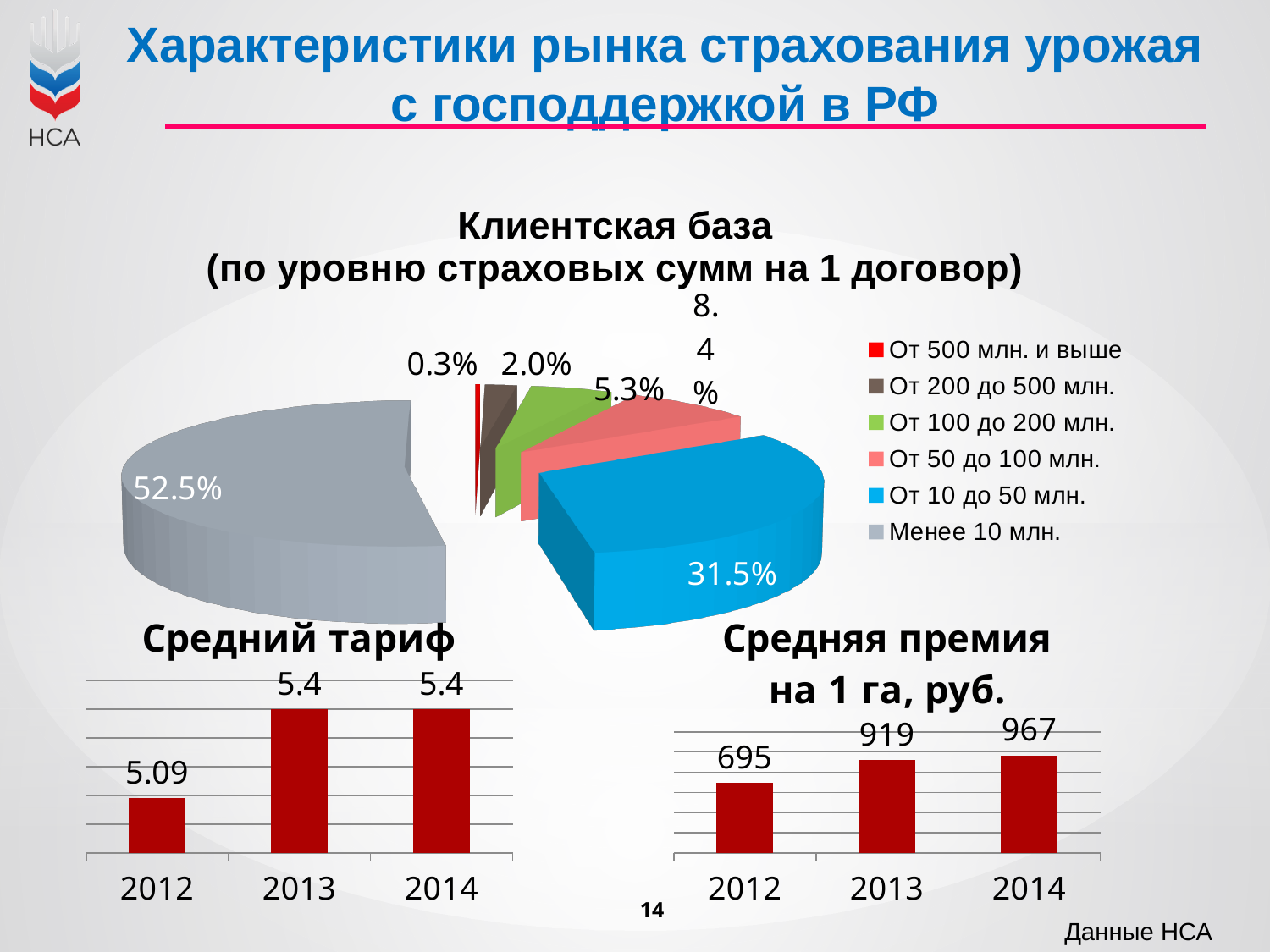
What type of chart is 'Средний тариф'? bar chart In the chart 'Средняя премия на 1 га, руб.', what is the value for 2013? 919 In the pie chart 'Клиентская база', what share is shown for the 'От 10 до 50 млн.' slice? 31.5% In the pie chart 'Клиентская база', which category has the largest share? Менее 10 млн. In the chart 'Средняя премия на 1 га, руб.', do the values rise or fall from 2012 to 2014? rise In the chart 'Средний тариф', what is the value for 2012? 5.09 In the pie chart 'Клиентская база', what share is shown for the 'От 500 млн. и выше' slice? 0.3% In the chart 'Средний тариф', what is the value for 2014? 5.4 How many categories does the legend of the pie chart 'Клиентская база' list? 6 In the pie chart 'Клиентская база', which category has the smallest share? От 500 млн. и выше In the chart 'Средняя премия на 1 га, руб.', what is the difference between the 2014 and 2012 values? 272 In the pie chart 'Клиентская база', what share is shown for the 'Менее 10 млн.' slice? 52.5%